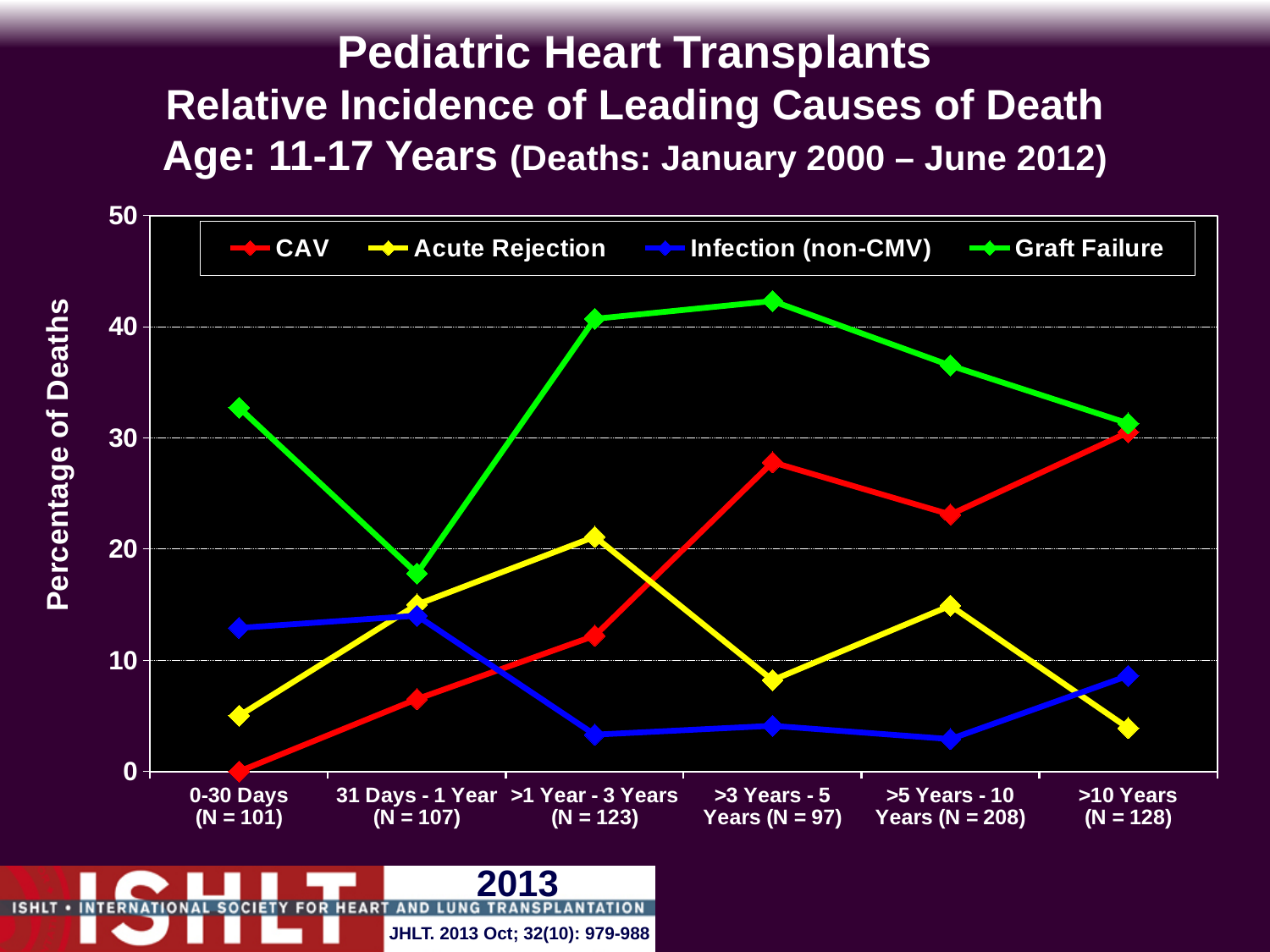
What is the value for CAV at 0-30 Days? 0 How many series does the legend list? 4 Is the value for CAV at >10 Years greater or less than 20? greater Is the value for Graft Failure at >3 Years - 5 Years greater or less than 40? greater In which time period is Graft Failure highest? >3 Years - 5 Years In which time period is CAV lowest? 0-30 Days Is the value for Graft Failure at 31 Days - 1 Year greater or less than 20? less Does the CAV line rise or fall from 0-30 Days to >3 Years - 5 Years? rise What kind of chart is shown on the slide? line chart How many time-period categories are shown on the x axis? 6 At >5 Years - 10 Years, which is larger: Graft Failure or CAV? Graft Failure